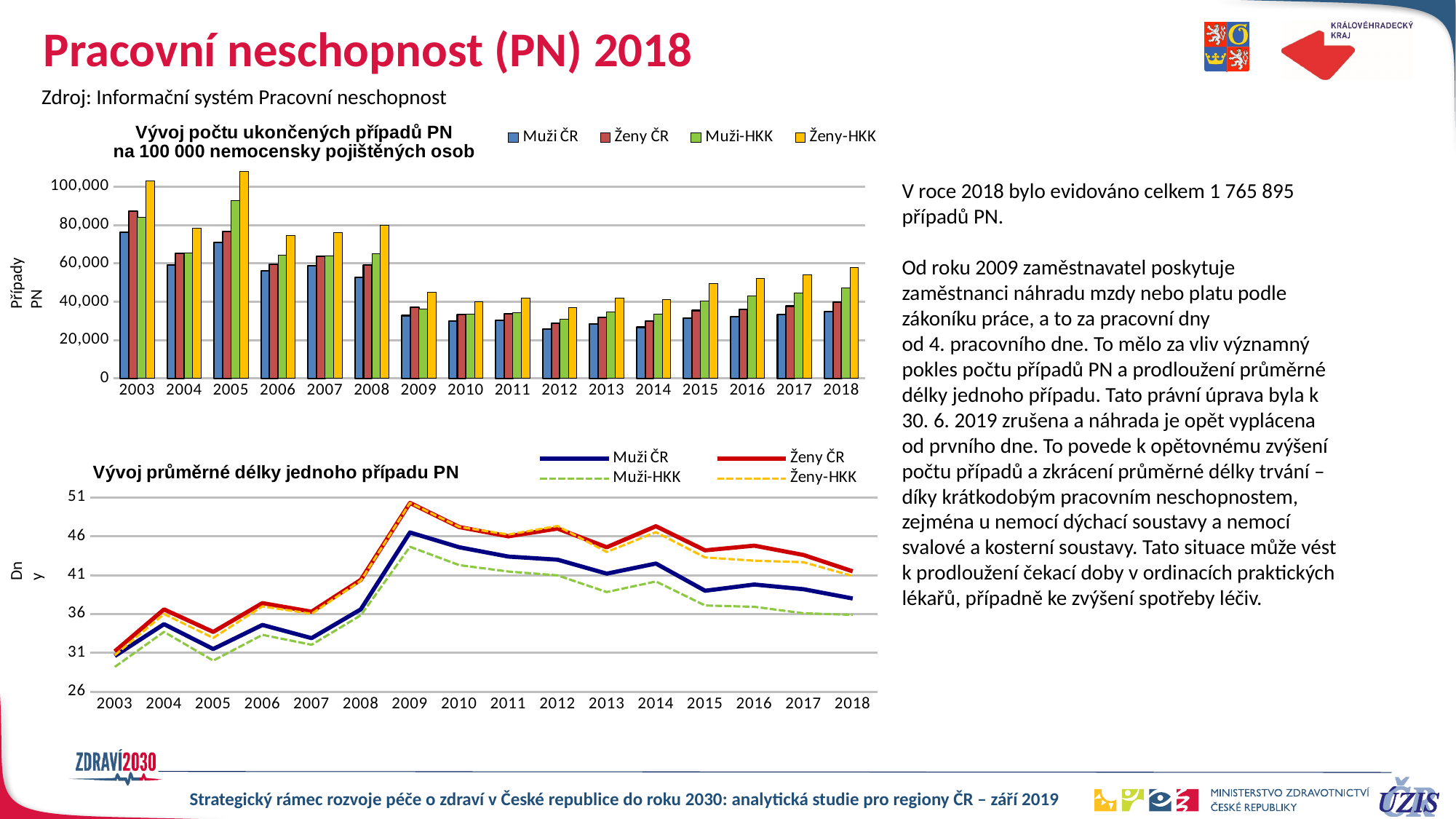
In the top bar chart, is the value for Ženy-HKK in 2005 greater or less than 100,000? greater In the bottom line chart, how many series does the legend list? 4 In the bottom line chart, in which year does Ženy ČR reach its highest value? 2009 What kind of chart is the bottom chart titled 'Vývoj průměrné délky jednoho případu PN'? line chart In the top bar chart, is the value for Muži ČR in 2003 greater or less than 60,000? greater In the top bar chart, which is larger in 2003: Muži ČR or Ženy ČR? Ženy ČR In the top bar chart, does the value for Muži ČR rise or fall from 2003 to 2009? fall What kind of chart is the top chart titled 'Vývoj počtu ukončených případů PN na 100 000 nemocensky pojištěných osob'? bar chart In the top bar chart, in which year is the value for Ženy-HKK highest? 2005 In the bottom line chart, does the value for Muži ČR rise or fall from 2014 to 2018? fall In the top bar chart, how many years are shown on the x axis? 16 In the bottom line chart, is the value for Muži-HKK in 2003 greater or less than 31? less